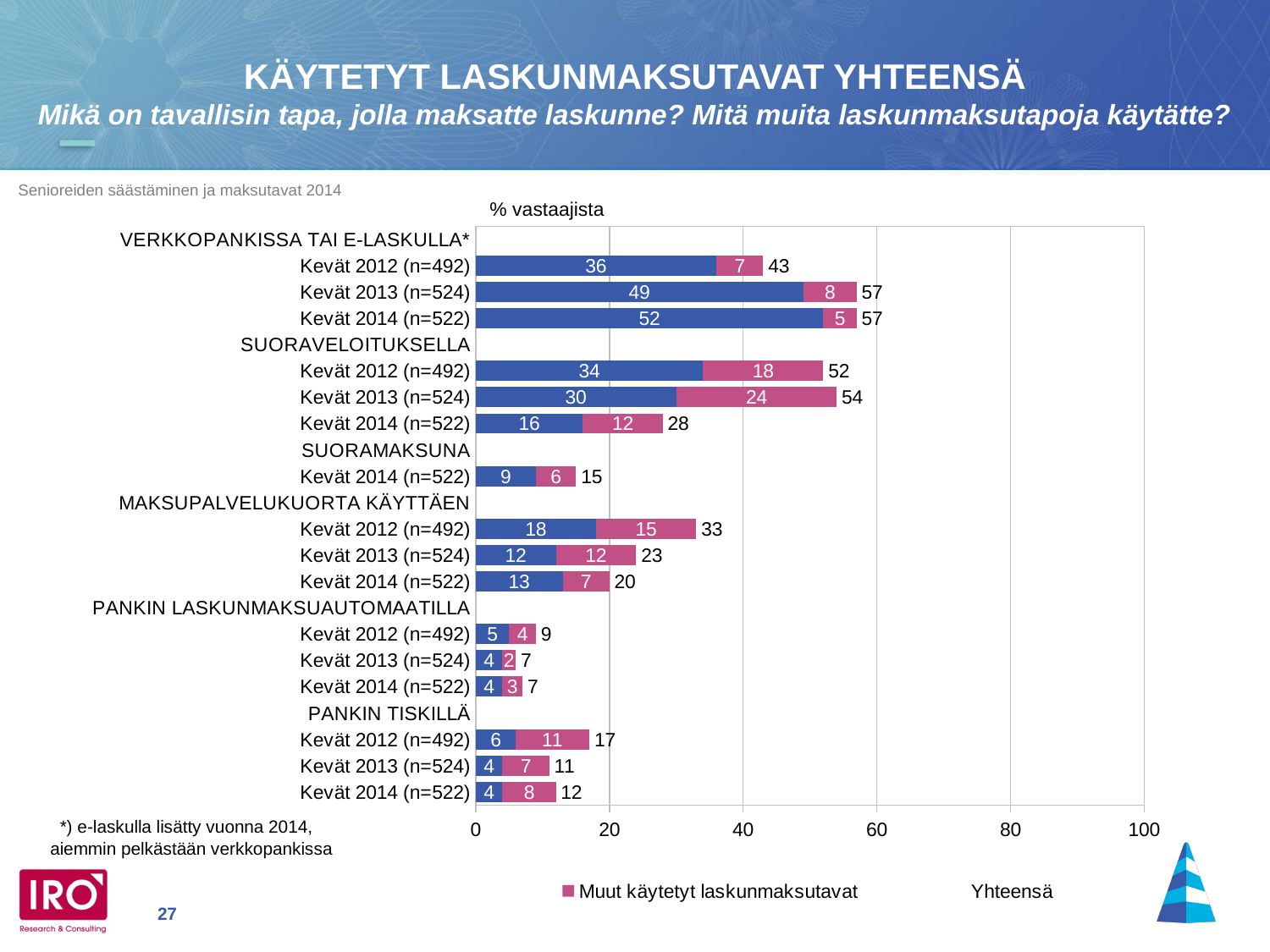
What kind of chart is shown on the slide? Stacked horizontal bar chart What is the difference between the total for Suoraveloituksella Kevät 2013 (n=524) and Suoraveloituksella Kevät 2014 (n=522)? 26 What is the 'Muut käytetyt laskunmaksutavat' value for Suoraveloituksella, Kevät 2013 (n=524)? 24 How does the total for Pankin tiskillä change from Kevät 2012 to Kevät 2013? It falls from 17 to 11 What is the total value for Pankin tiskillä, Kevät 2012 (n=492)? 17 Is the total for Verkkopankissa tai e-laskulla, Kevät 2012 (n=492) greater or less than 40? greater What is the total value for Suoramaksuna, Kevät 2014 (n=522)? 15 Which is larger: the total for Maksupalvelukuorta käyttäen Kevät 2012 (n=492) or Suoraveloituksella Kevät 2014 (n=522)? Maksupalvelukuorta käyttäen Kevät 2012 (n=492) What is the total (Yhteensä) value for Verkkopankissa tai e-laskulla, Kevät 2014 (n=522)? 57 What is the label on the x axis of the chart? % vastaajista How many bars are plotted in the chart? 16 Which bar has the lowest total value? Pankin laskunmaksuautomaatilla, Kevät 2013 (n=524) and Kevät 2014 (n=522), both 7